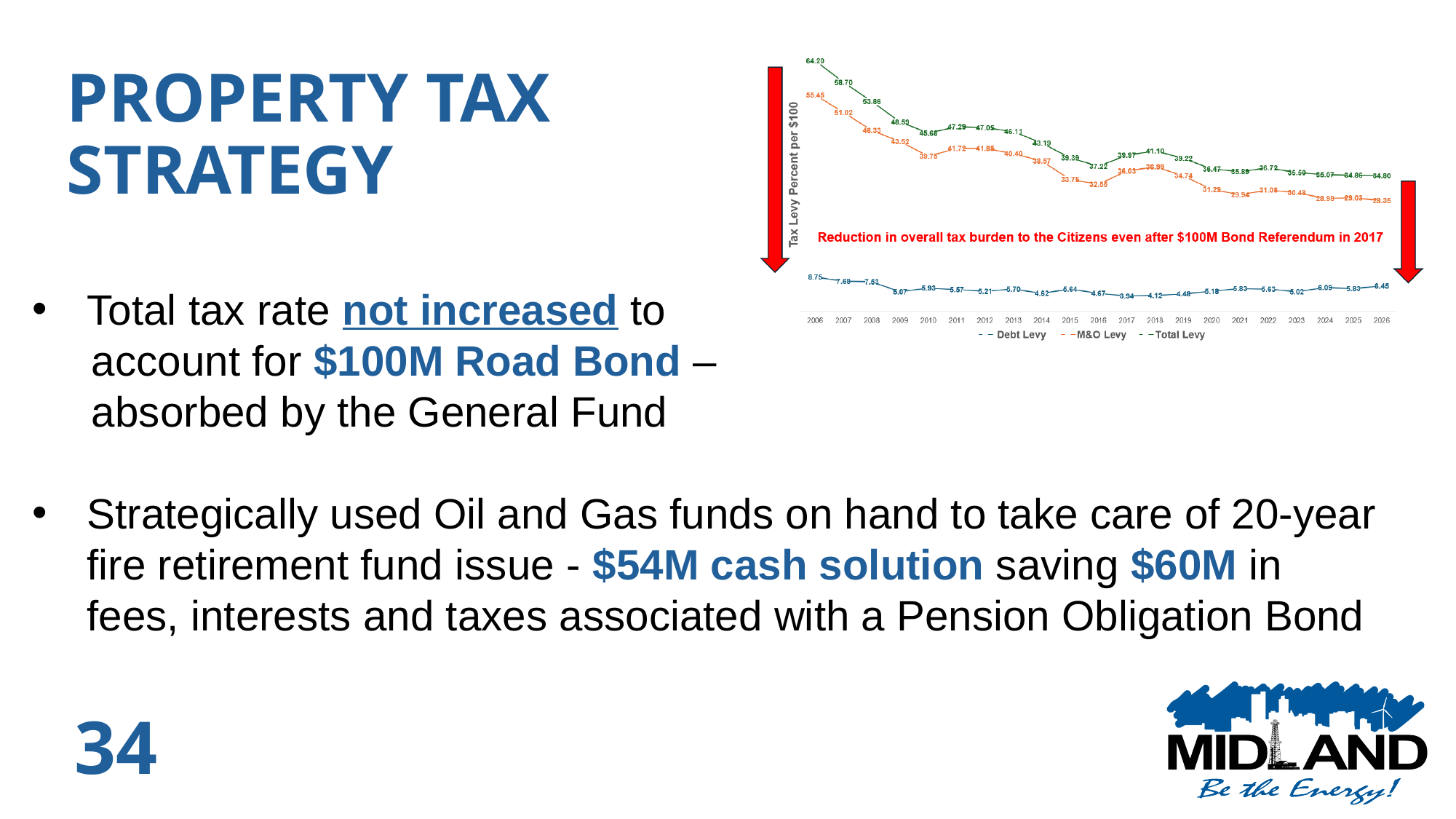
What is the Total Levy value for 2026? 34.80 What kind of chart is shown on the slide? line chart What is the difference between the Total Levy in 2006 and in 2026? 29.40 How many series does the chart legend list? 3 Does the Total Levy generally rise or fall from 2006 to 2026? fall What is the Total Levy value for 2006? 64.20 What are the three series listed in the chart legend? Debt Levy, M&O Levy, Total Levy What is the M&O Levy value for 2006? 55.45 Which series has the lowest values across the chart? Debt Levy What is the Debt Levy value for 2006? 8.75 In which year is the Total Levy highest? 2006 Which is larger, the Total Levy in 2006 or the Total Levy in 2026? Total Levy in 2006